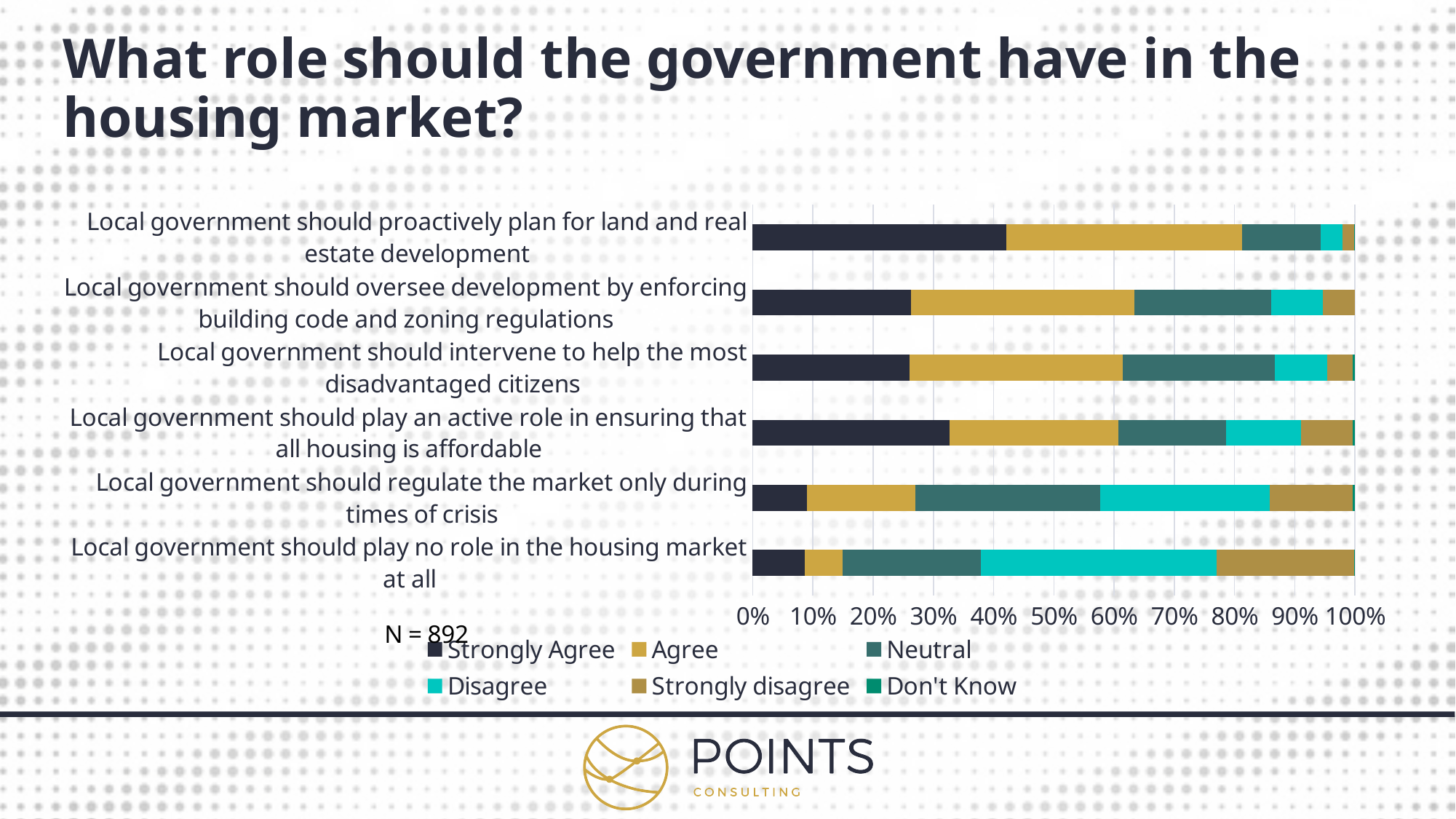
Is the Strongly Agree value for 'Local government should proactively plan for land and real estate development' greater or less than 30%? greater Is the Strongly Agree value for 'Local government should regulate the market only during times of crisis' greater or less than 20%? less Which has the larger Disagree segment: 'Local government should play no role in the housing market at all' or 'Local government should regulate the market only during times of crisis'? Local government should play no role in the housing market at all What is the sample size (N) stated on the slide? N = 892 How many statements (categories) are plotted in the chart? 6 Which legend entry is shown in the darkest colour? Strongly Agree What kind of chart is shown on the slide? Stacked bar chart Is the Disagree value for 'Local government should play no role in the housing market at all' greater or less than 30%? greater Which statement has the largest Strongly Agree segment? Local government should proactively plan for land and real estate development Which statement has the largest Disagree segment? Local government should play no role in the housing market at all Which statement has the largest Strongly disagree segment? Local government should play no role in the housing market at all How many series does the chart legend list? 6